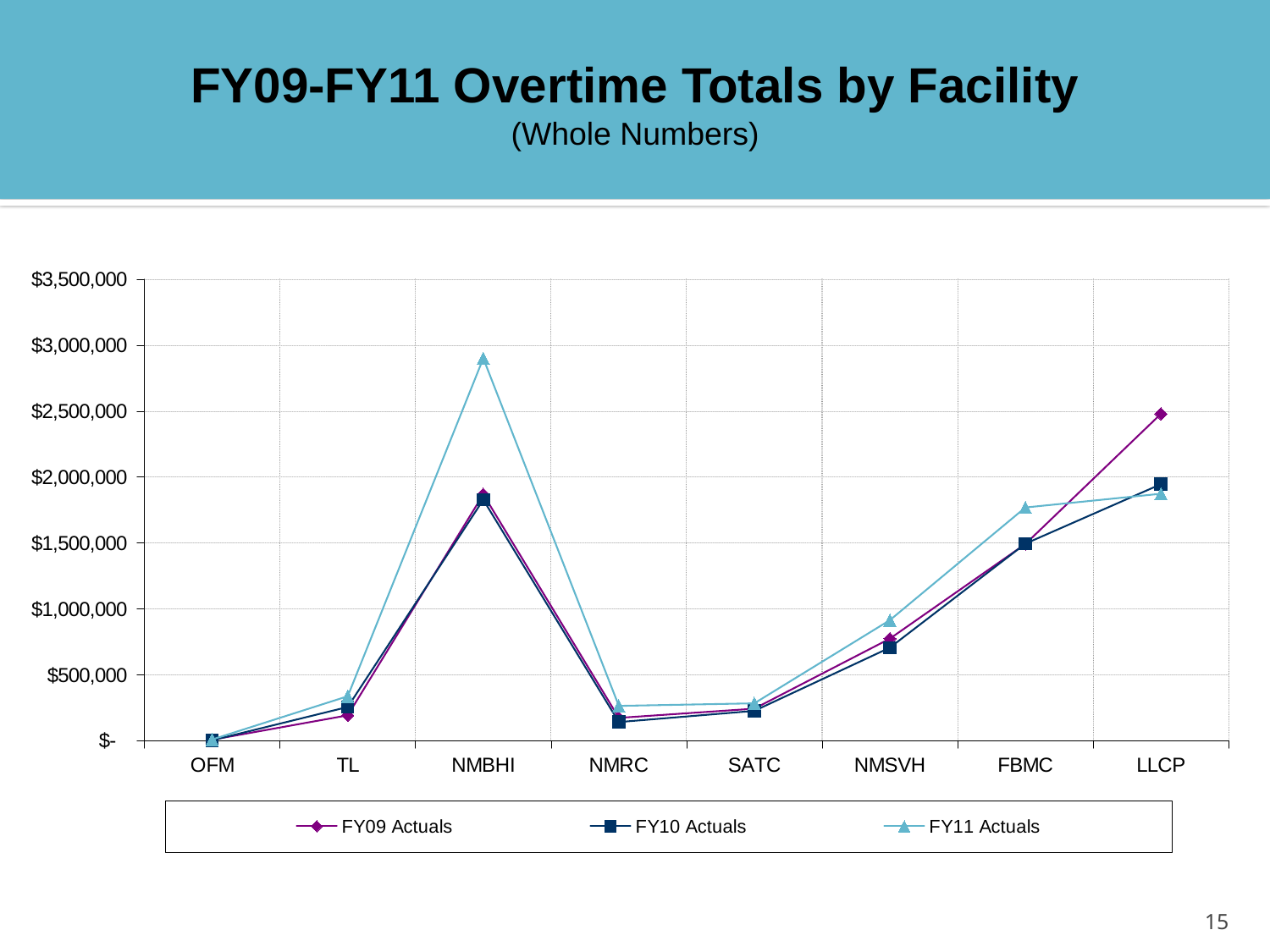
At NMBHI, which is larger: FY11 Actuals or FY09 Actuals? FY11 Actuals How many facilities are shown along the x axis? 8 Is the FY11 Actuals value for NMBHI greater or less than $2,500,000? greater Which facility has the lowest overtime total across all three fiscal years? OFM Is the FY09 Actuals value for LLCP greater or less than $2,000,000? greater How many series does the legend list? 3 Which facility has the highest FY11 Actuals value? NMBHI At LLCP, which is larger: FY09 Actuals or FY11 Actuals? FY09 Actuals Is the FY10 Actuals value for NMSVH greater or less than $1,000,000? less What are the three series names listed in the legend? FY09 Actuals, FY10 Actuals, FY11 Actuals What kind of chart is shown on the slide? Line chart Which facility has the highest FY09 Actuals value? LLCP